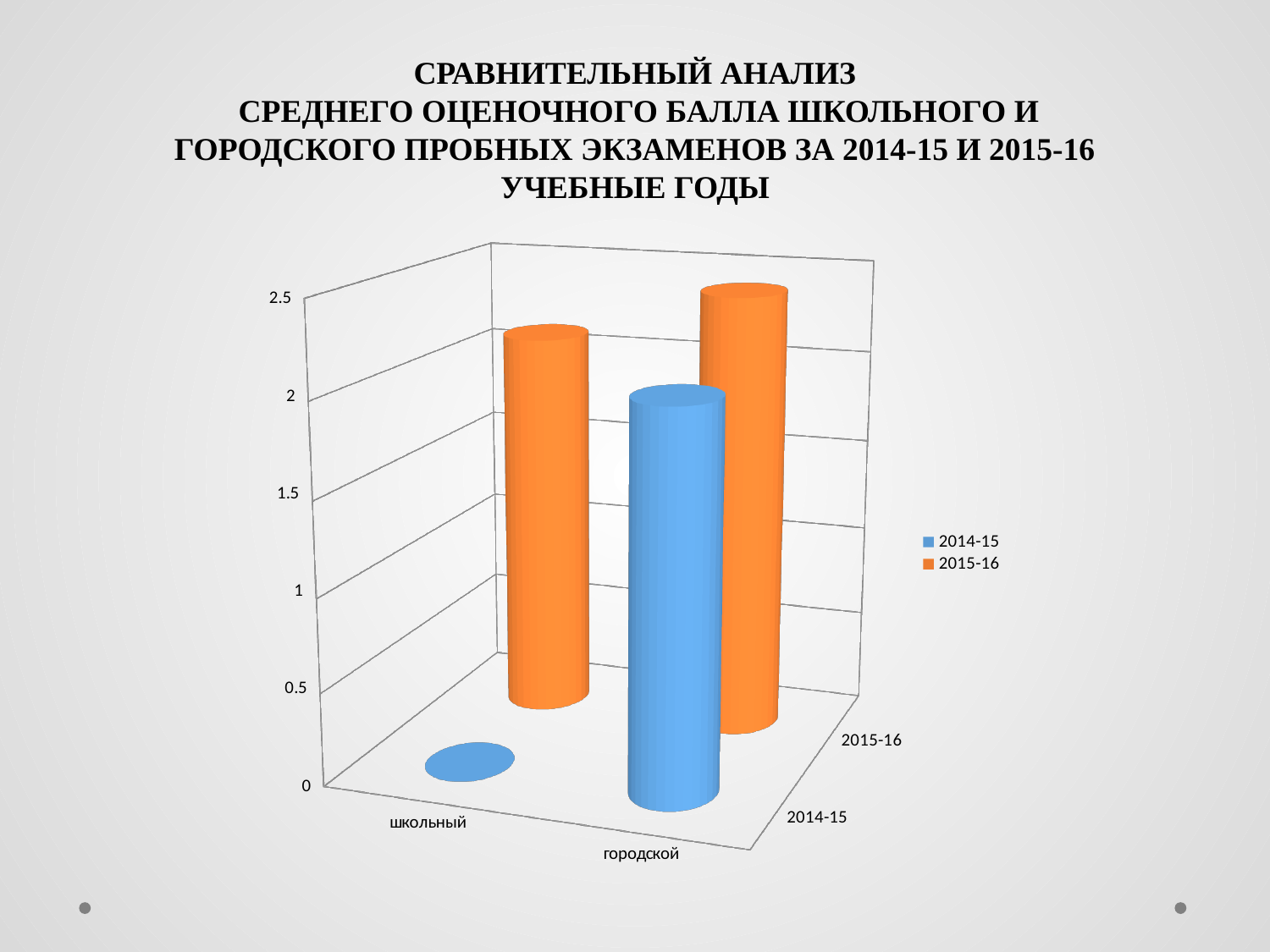
Is the value for городской in 2015-16 greater or less than 2.5? less Is the value for школьный in 2015-16 greater or less than 2? greater Which series is shown in blue? 2014-15 Which category and series combination has the lowest value? школьный, 2014-15 Which series is shown in orange? 2015-16 What kind of chart is shown on the slide? bar chart For the 2015-16 series, which is larger: школьный or городской? городской How many categories are shown on the category axis? 2 Which category has the highest value for the 2015-16 series? городской For the 2014-15 series, do the values rise or fall from школьный to городской? rise Is the value for городской in 2014-15 greater or less than 1.5? greater How many series does the legend list? 2